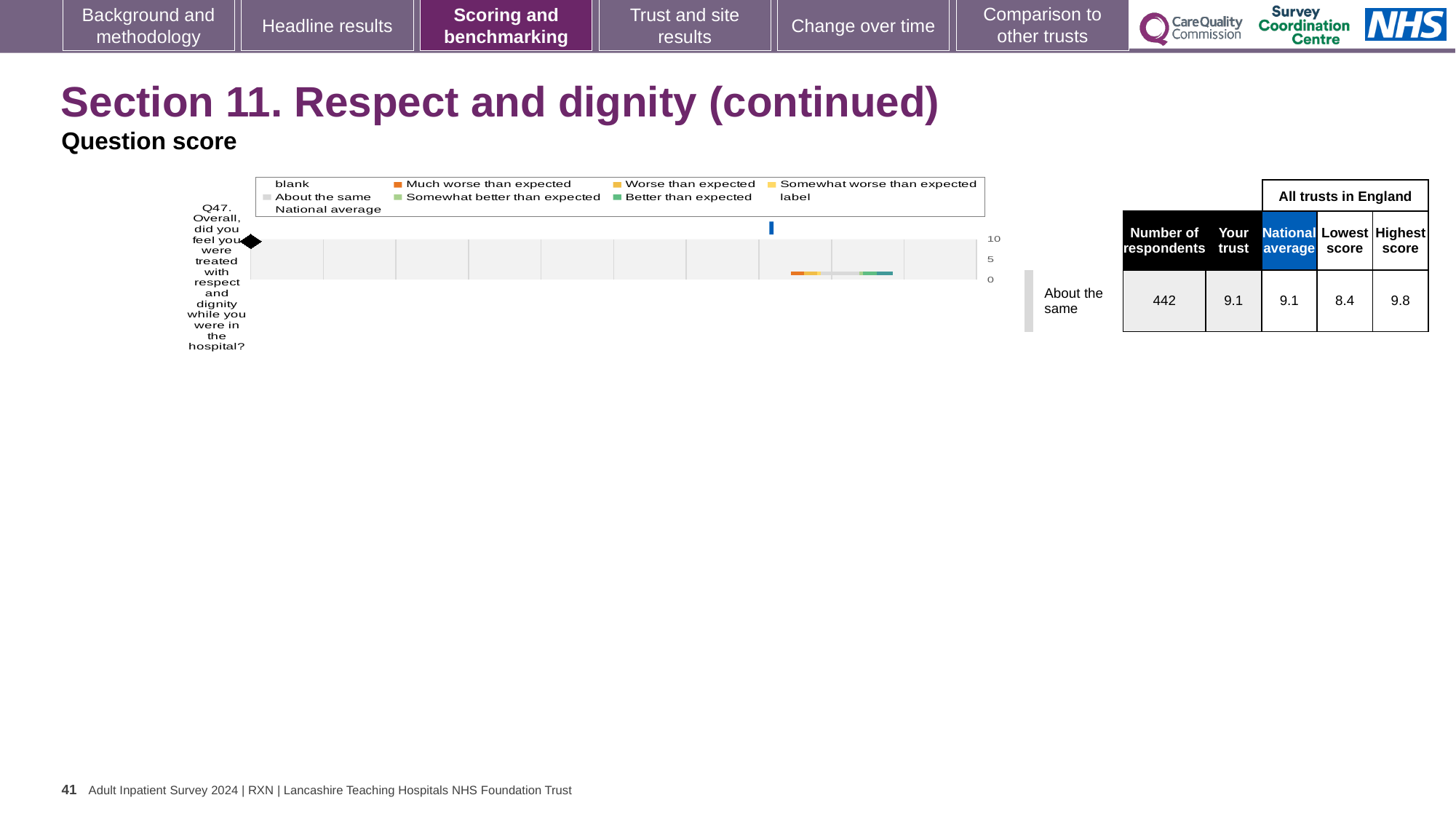
How many survey questions are plotted on this chart? 1 What is the highest score among all trusts in England for Q47? 9.8 Is the trust's Q47 score higher or lower than the highest score in England (9.8)? lower What is the lowest score among all trusts in England for Q47? 8.4 Which legend entry is shown in dark green? Better than expected Which benchmark category is the trust's Q47 result placed in? About the same Is the trust's score for Q47 greater or less than 5 on the chart axis? greater How many respondents answered Q47? 442 What is the 'Your trust' score for Q47 shown next to the chart? 9.1 What is the national average score for Q47? 9.1 What is the difference between the highest and lowest trust scores for Q47? 1.4 What is the highest tick value shown on the chart's axis? 10